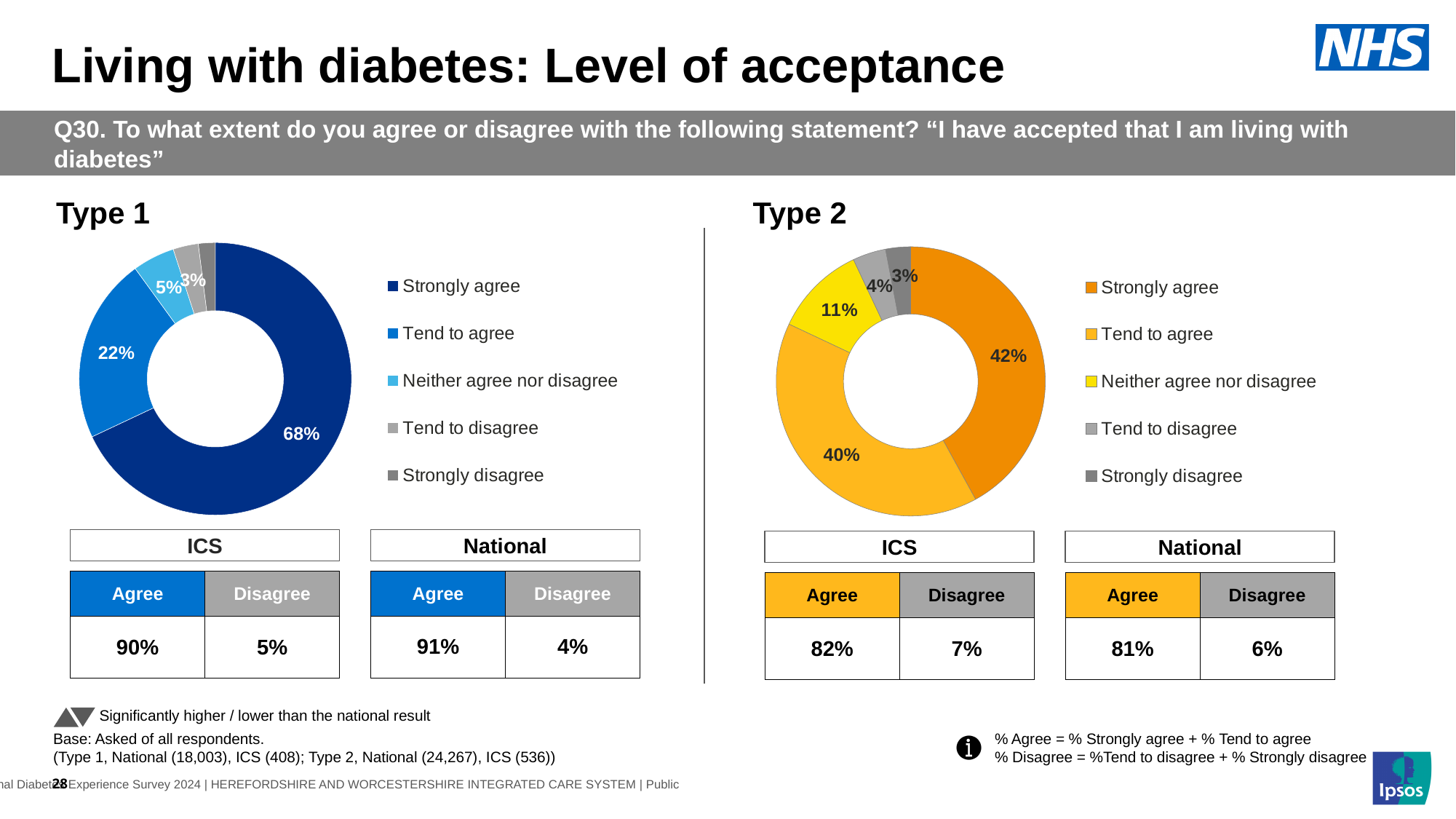
In the Type 1 chart, what percentage of respondents strongly agree? 68% In the Type 2 chart, what is the difference between the Strongly agree and Tend to agree shares? 2% What kind of chart is used for Type 1? Donut chart In the Type 1 chart, what colour represents Strongly agree? Dark blue In the Type 2 chart, what percentage of respondents tend to disagree? 4% How many categories does the legend of the Type 2 chart list? 5 In the Type 2 chart, what percentage of respondents neither agree nor disagree? 11% In the Type 1 chart, what percentage of respondents tend to agree? 22% In the Type 1 chart, which is larger: Tend to agree or Neither agree nor disagree? Tend to agree In the Type 2 chart, which category has the smallest share? Strongly disagree In the Type 1 chart, which category has the largest share? Strongly agree In the Type 2 chart, what percentage of respondents strongly agree? 42%